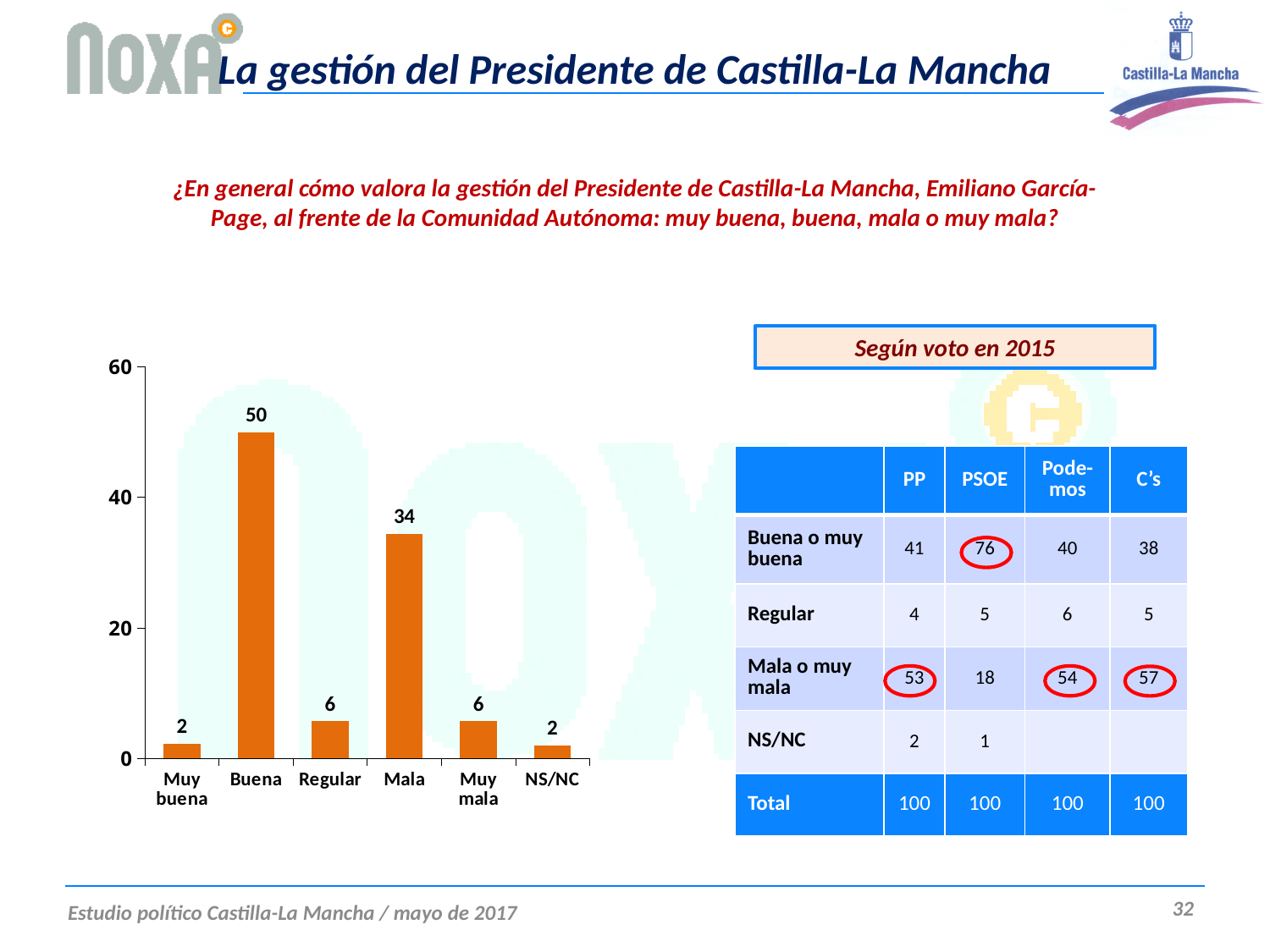
What is the highest value shown on the y axis of the bar chart? 60 What is the value for Mala in the bar chart? 34 What is the value for Regular in the bar chart? 6 What is the difference between the values for Regular and NS/NC in the bar chart? 4 What is the value for Buena in the bar chart? 50 What is the difference between the values for Buena and Mala in the bar chart? 16 Which category has the highest value in the bar chart? Buena What is the value for Muy buena in the bar chart? 2 How many categories are shown on the x axis of the bar chart? 6 What kind of chart is shown on the slide? bar chart Which is larger in the bar chart, the value for Mala or the value for Muy mala? Mala Is the value for Mala in the bar chart greater or less than 40? less